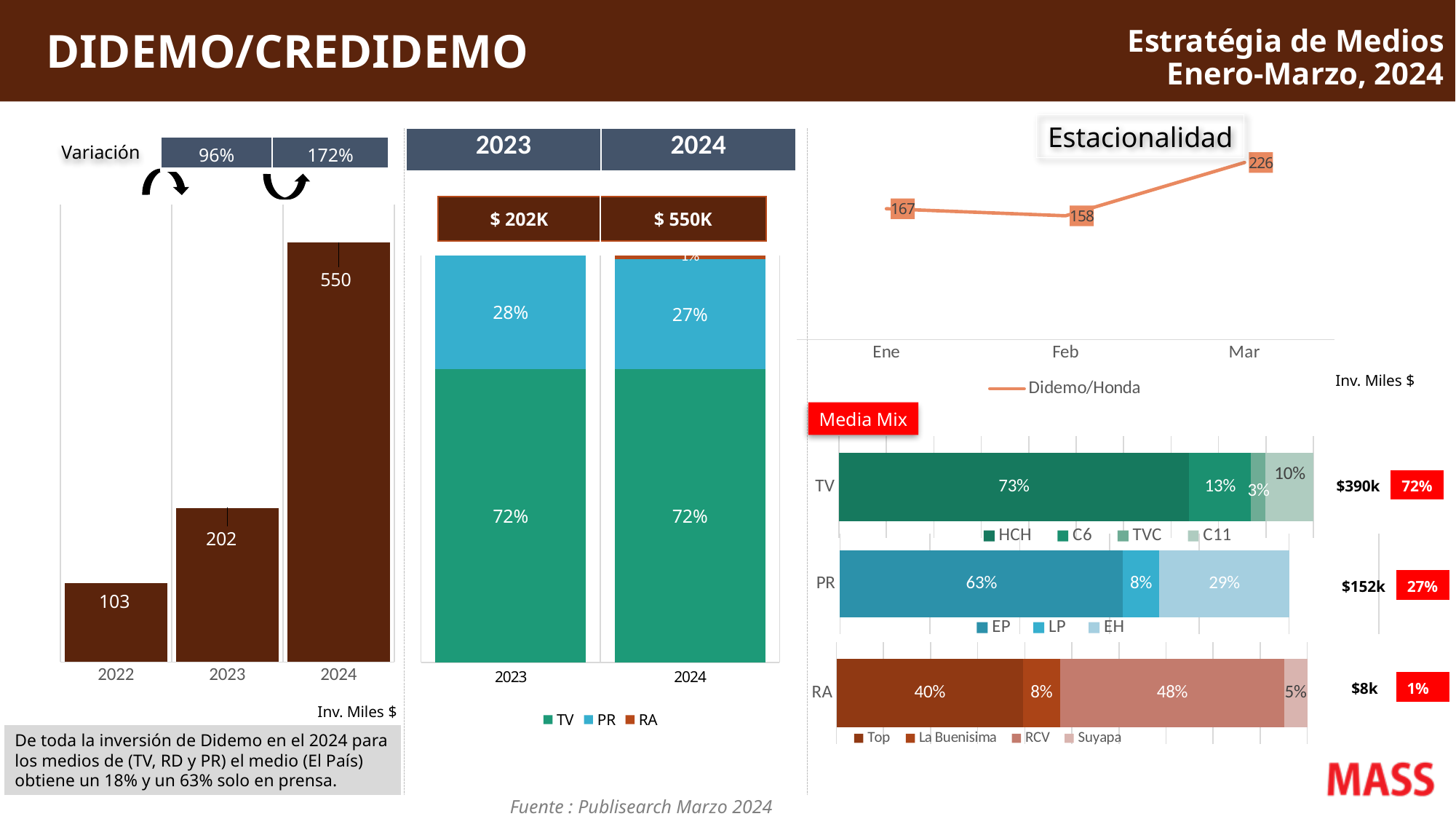
In the Estacionalidad chart, what is the value for Feb? 158 In the Media Mix chart, what is the difference between the EP and EH shares in the PR bar? 34% In the bar chart on the left of the slide, which year has the lowest value? 2022 In the bar chart on the left of the slide, do the values rise or fall from 2022 to 2024? rise In the Media Mix chart, what share does HCH have in the TV bar? 73% In the stacked bar chart in the middle of the slide, how many series does the legend list? 3 In the stacked bar chart in the middle of the slide, what share does PR have in 2023? 28% What kind of chart is the Estacionalidad chart? line chart In the bar chart on the left of the slide, what is the difference between the 2024 and 2023 values? 348 In the Estacionalidad chart, which month has the highest value? Mar In the bar chart on the left of the slide, what is the value for 2024? 550 In the Media Mix chart, which is larger in the RA bar: Top or RCV? RCV